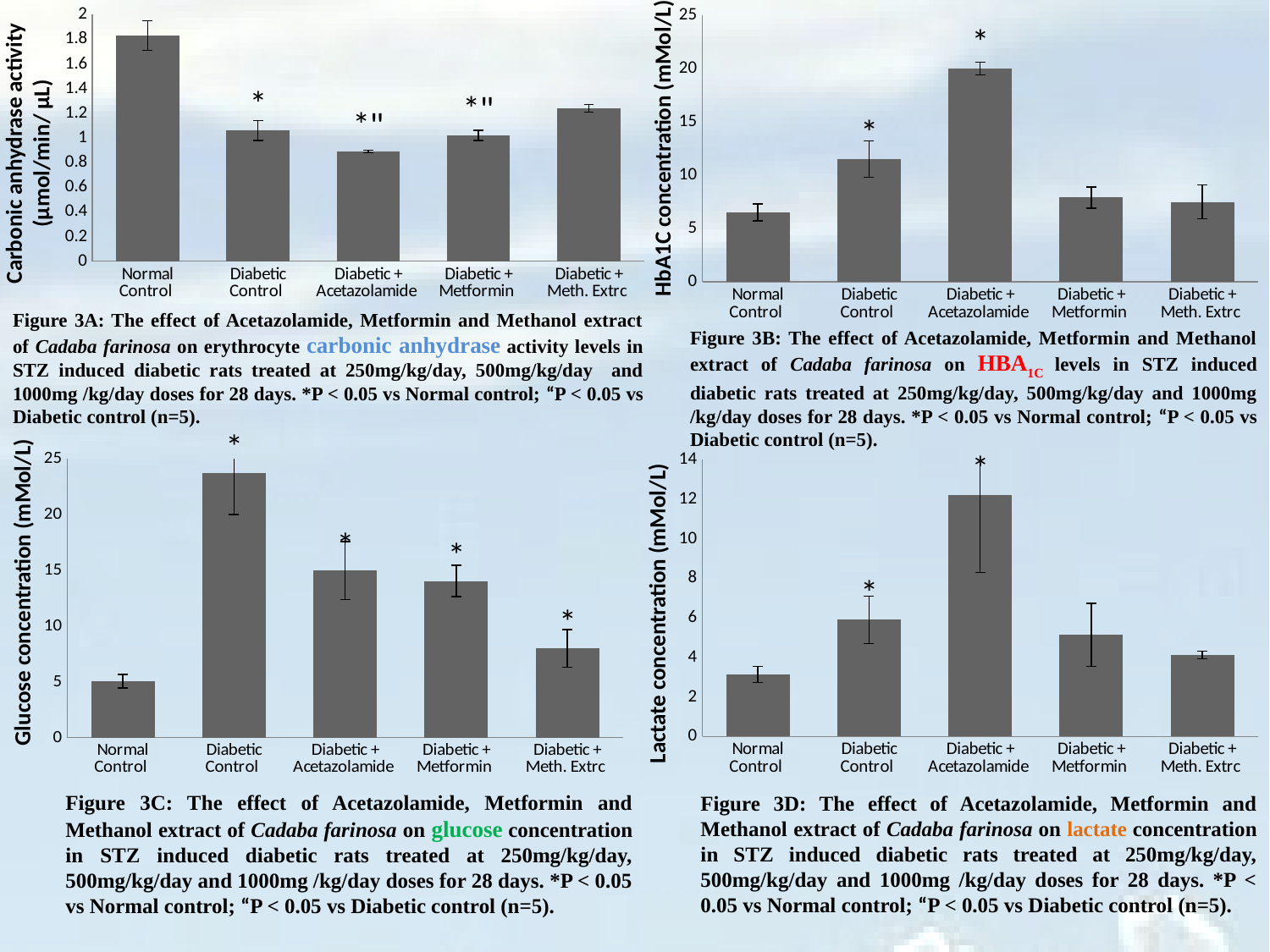
In Figure 3C (glucose concentration), which group has the lowest bar? Normal Control In Figure 3A (carbonic anhydrase activity), which group has the lowest bar? Diabetic + Acetazolamide In Figure 3B (HbA1C concentration), is the value for Diabetic Control greater or less than 10? greater In Figure 3C (glucose concentration), is the value for Diabetic + Meth. Extrc greater or less than 10? less In Figure 3B (HbA1C concentration), which group has the highest bar? Diabetic + Acetazolamide In Figure 3A (carbonic anhydrase activity), which group has the highest bar? Normal Control In Figure 3D (lactate concentration), which group has the highest bar? Diabetic + Acetazolamide What type of chart is Figure 3D (lactate concentration)? Bar chart In Figure 3D (lactate concentration), how many groups are shown on the x axis? 5 In Figure 3B (HbA1C concentration), which is larger, the value for Normal Control or the value for Diabetic Control? Diabetic Control In Figure 3A (carbonic anhydrase activity), is the value for Normal Control greater or less than 1.6? greater